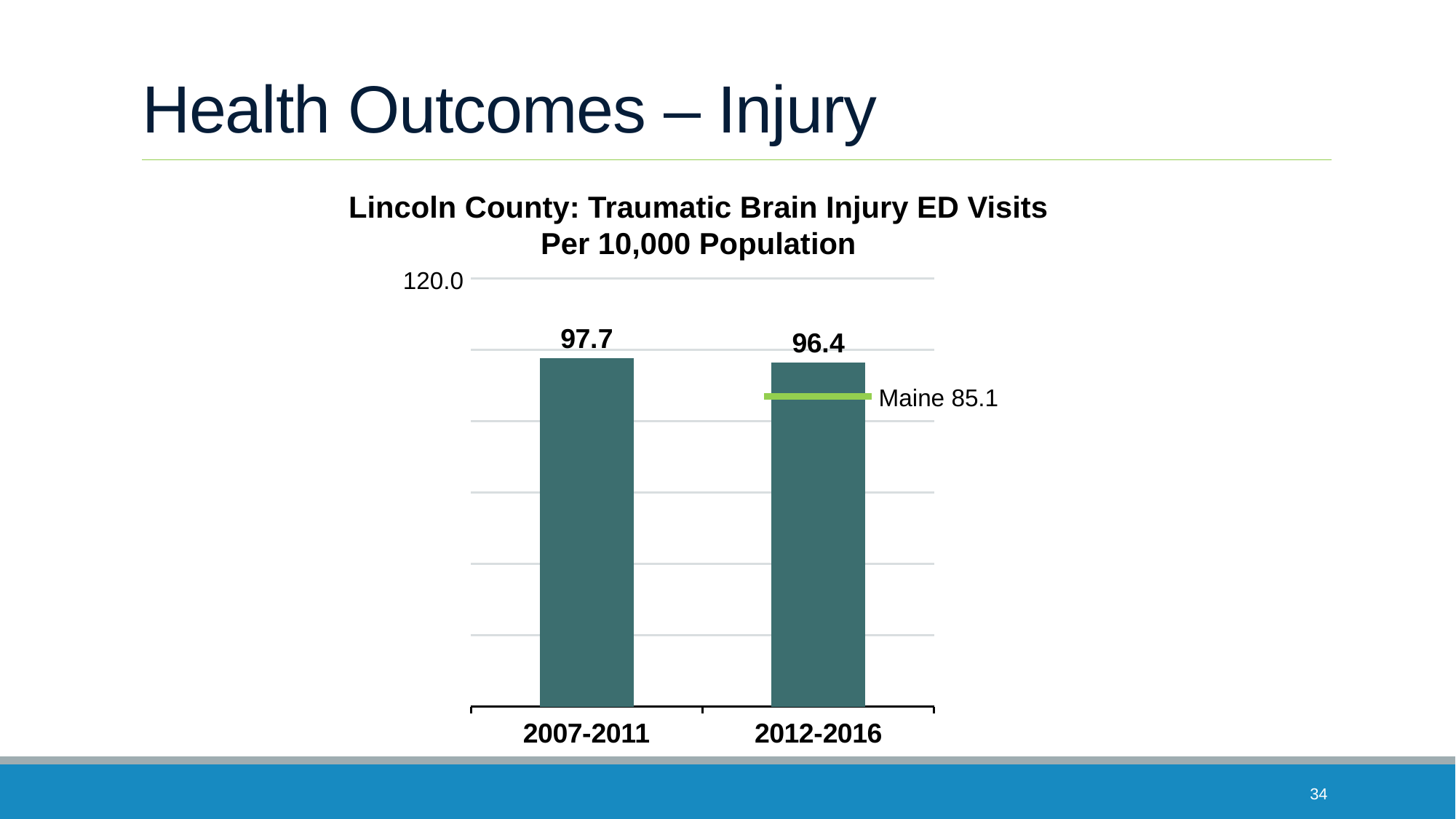
What kind of chart is shown? bar chart Which period has the higher value? 2007-2011 How much higher is the 2012-2016 value than the Maine value of 85.1? 11.3 What is the Maine value shown by the reference line? 85.1 What is the value for 2007-2011? 97.7 Do the values rise or fall from 2007-2011 to 2012-2016? fall How many bars are plotted in the chart? 2 Is the value for 2012-2016 greater or less than the Maine value? greater Which period has the lower value? 2012-2016 What is the difference between the 2007-2011 and 2012-2016 values? 1.3 Is the value for 2007-2011 greater or less than 120.0? less What is the value for 2012-2016? 96.4